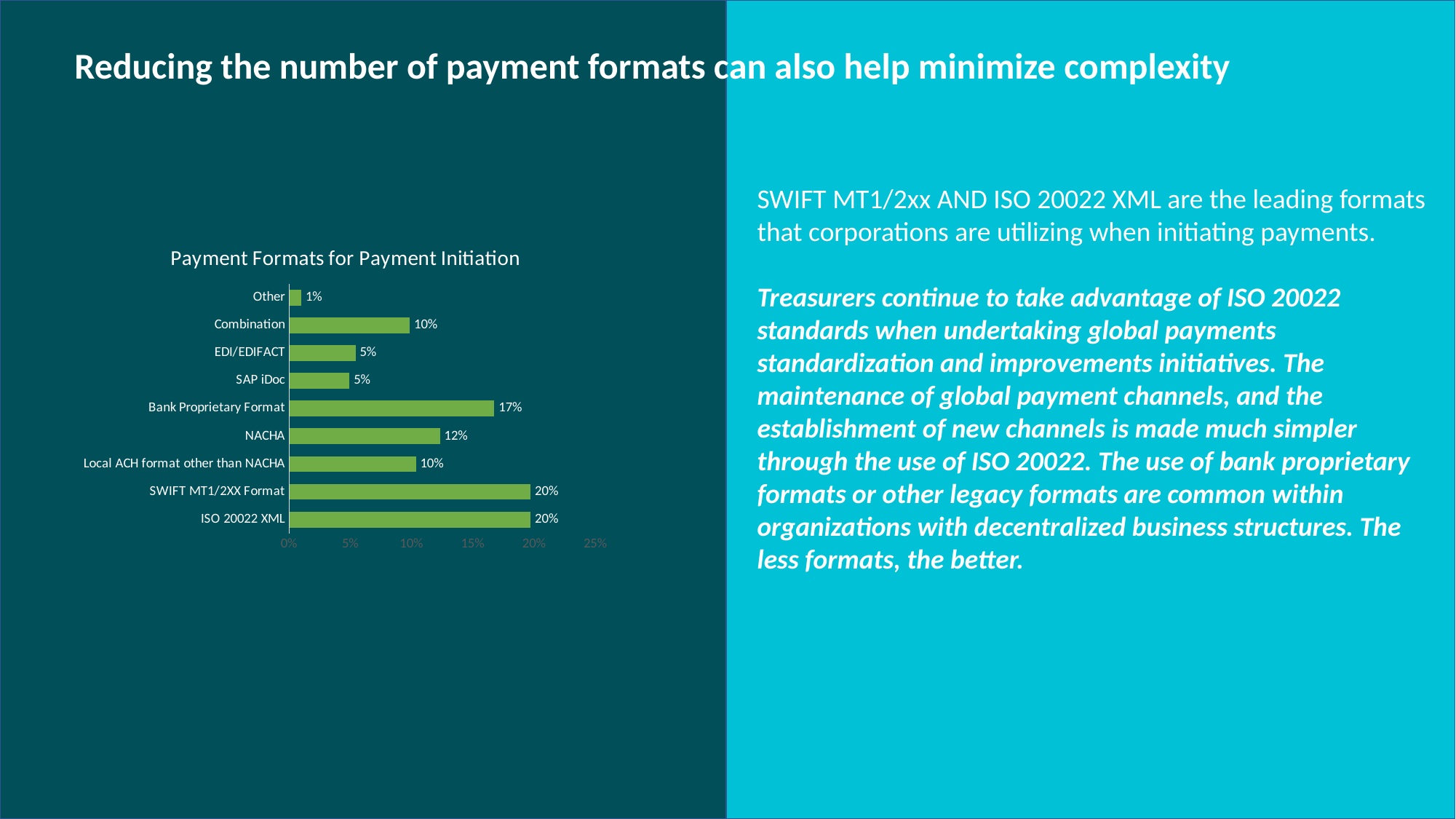
Which is larger, the value for NACHA or the value for EDI/EDIFACT? NACHA What is the value for NACHA? 12% What is the value for Other? 1% What is the title of the chart? Payment Formats for Payment Initiation What is the difference between the values for Bank Proprietary Format and NACHA? 5% Is the value for SWIFT MT1/2XX Format greater or less than 15%? greater What kind of chart is shown on the slide? bar chart Which category has the lowest value? Other What is the value for Bank Proprietary Format? 17% How many categories are shown in the chart? 9 What is the value for Combination? 10% What is the difference between the values for ISO 20022 XML and SAP iDoc? 15%